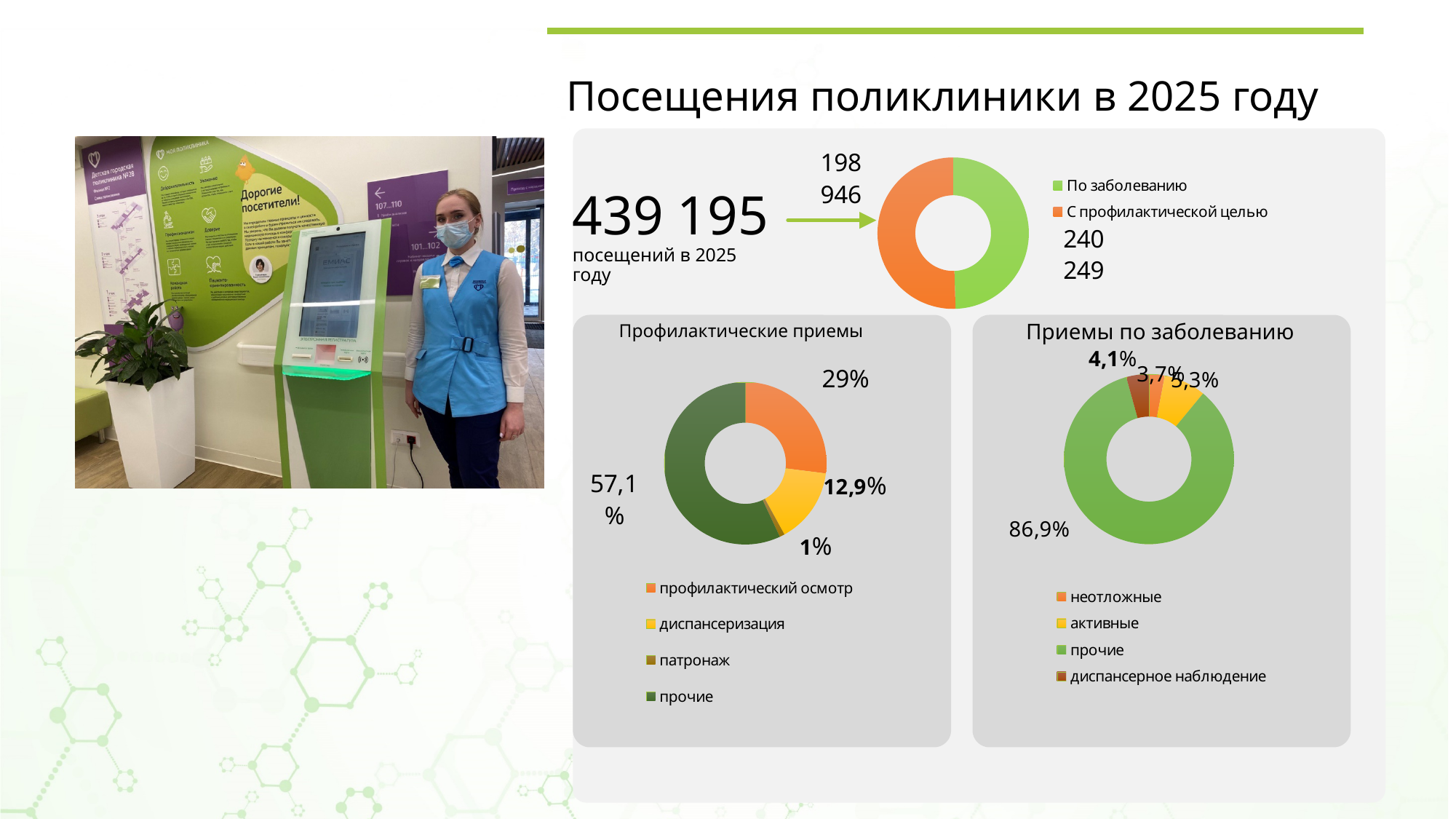
In the 'Приемы по заболеванию' chart, what share is 'диспансерное наблюдение'? 4,1% In the 'Профилактические приемы' chart, what share is 'диспансеризация'? 12,9% In the top donut chart, what is the difference between visits 'По заболеванию' and visits 'С профилактической целью'? 41 303 In the top donut chart, how many visits were 'По заболеванию'? 240 249 In the 'Профилактические приемы' chart, which category has the smallest share? патронаж In the top donut chart, which is larger: 'По заболеванию' or 'С профилактической целью'? По заболеванию In the top donut chart, how many visits were 'С профилактической целью'? 198 946 What type of chart is used for 'Профилактические приемы'? Donut (pie) chart In the 'Профилактические приемы' chart, what share is 'профилактический осмотр'? 29% In the 'Приемы по заболеванию' chart, what share is 'прочие'? 86,9% How many categories does the legend of the 'Приемы по заболеванию' chart list? 4 In the 'Профилактические приемы' chart, which category has the largest share? прочие